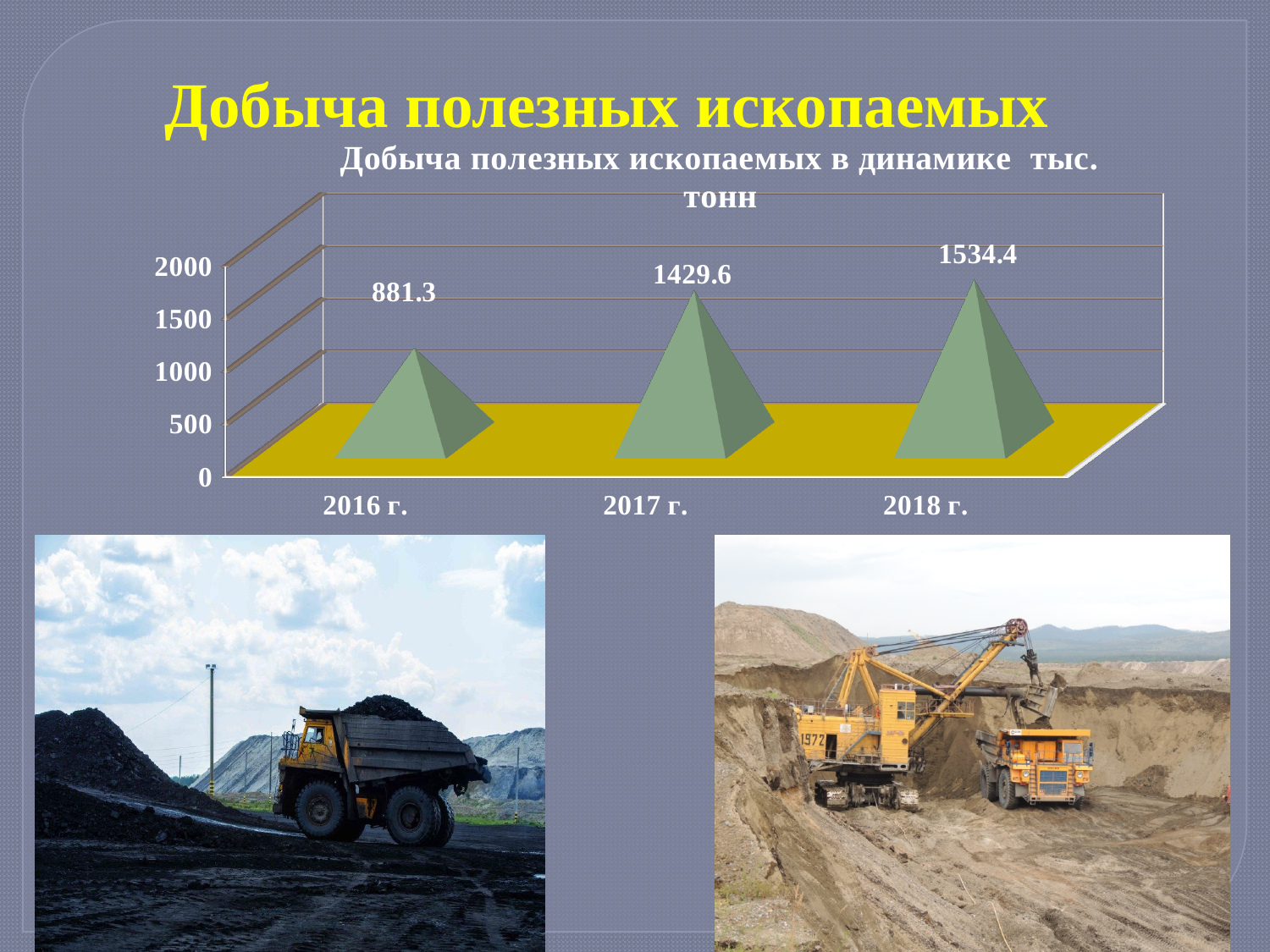
Which year has the lowest value? 2016 г. What is the value for 2017 г.? 1429.6 Do the values rise or fall from 2016 г. to 2018 г.? rise Which is larger, the value for 2016 г. or the value for 2017 г.? 2017 г. Is the value for 2016 г. greater or less than 1000? less What is the difference between the values for 2017 г. and 2016 г.? 548.3 What is the value for 2018 г.? 1534.4 How many years are shown on the x axis? 3 Which year has the highest value? 2018 г. What is the value for 2016 г.? 881.3 What is the difference between the values for 2018 г. and 2017 г.? 104.8 What is the title of the chart? Добыча полезных ископаемых в динамике тыс. тонн